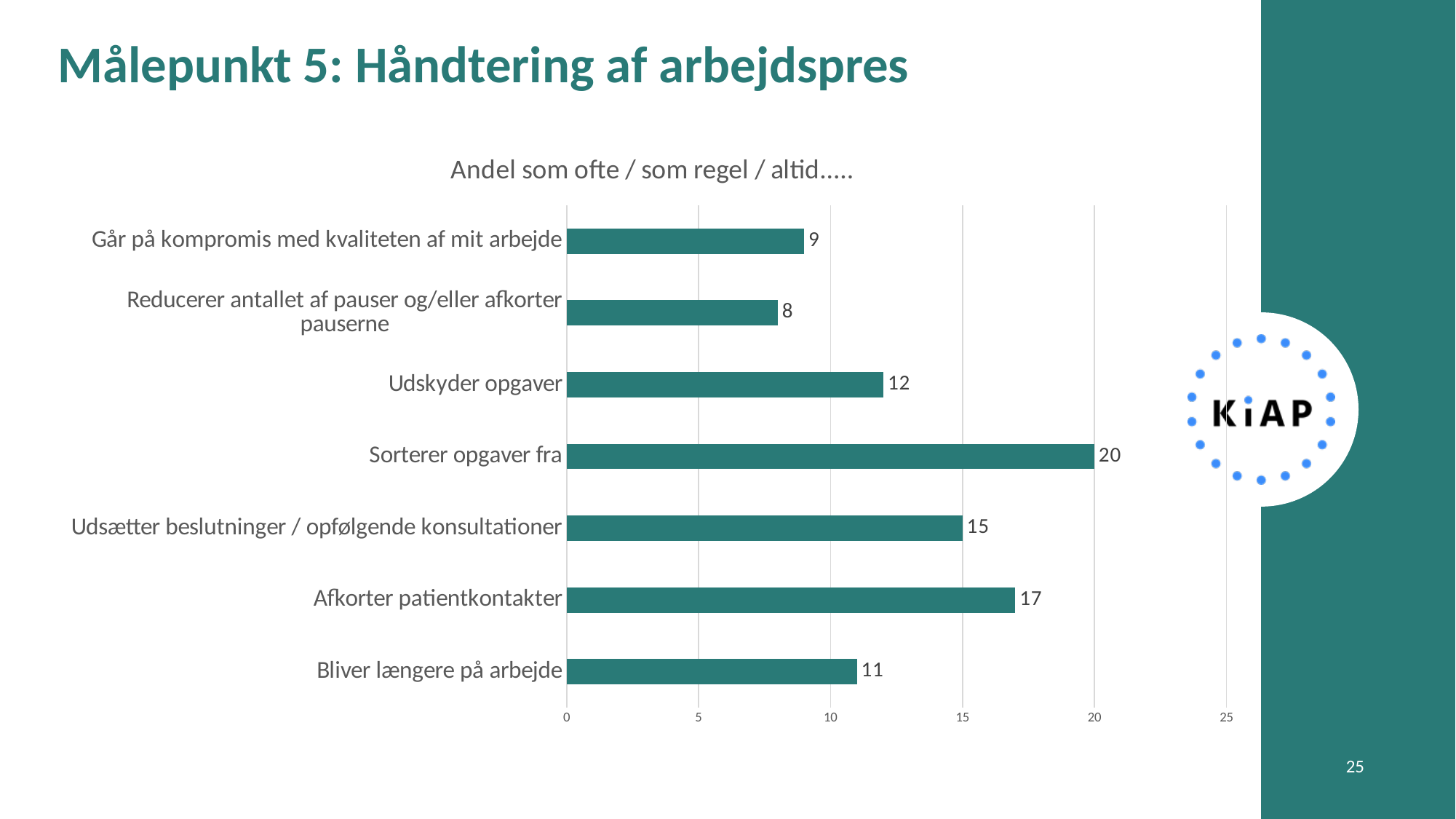
What is the value for "Bliver længere på arbejde"? 11 Is the value for "Afkorter patientkontakter" greater or less than 15? greater How many categories are shown in the chart? 7 What is the value for "Reducerer antallet af pauser og/eller afkorter pauserne"? 8 What is the value for "Sorterer opgaver fra"? 20 What is the highest value shown on the x axis? 25 What is the title of the chart? Andel som ofte / som regel / altid….. Which category has the lowest value? Reducerer antallet af pauser og/eller afkorter pauserne What is the difference between the values for "Afkorter patientkontakter" and "Udskyder opgaver"? 5 Which category has the highest value? Sorterer opgaver fra Which is larger, the value for "Udsætter beslutninger / opfølgende konsultationer" or the value for "Går på kompromis med kvaliteten af mit arbejde"? Udsætter beslutninger / opfølgende konsultationer What kind of chart is shown on the slide? Bar chart